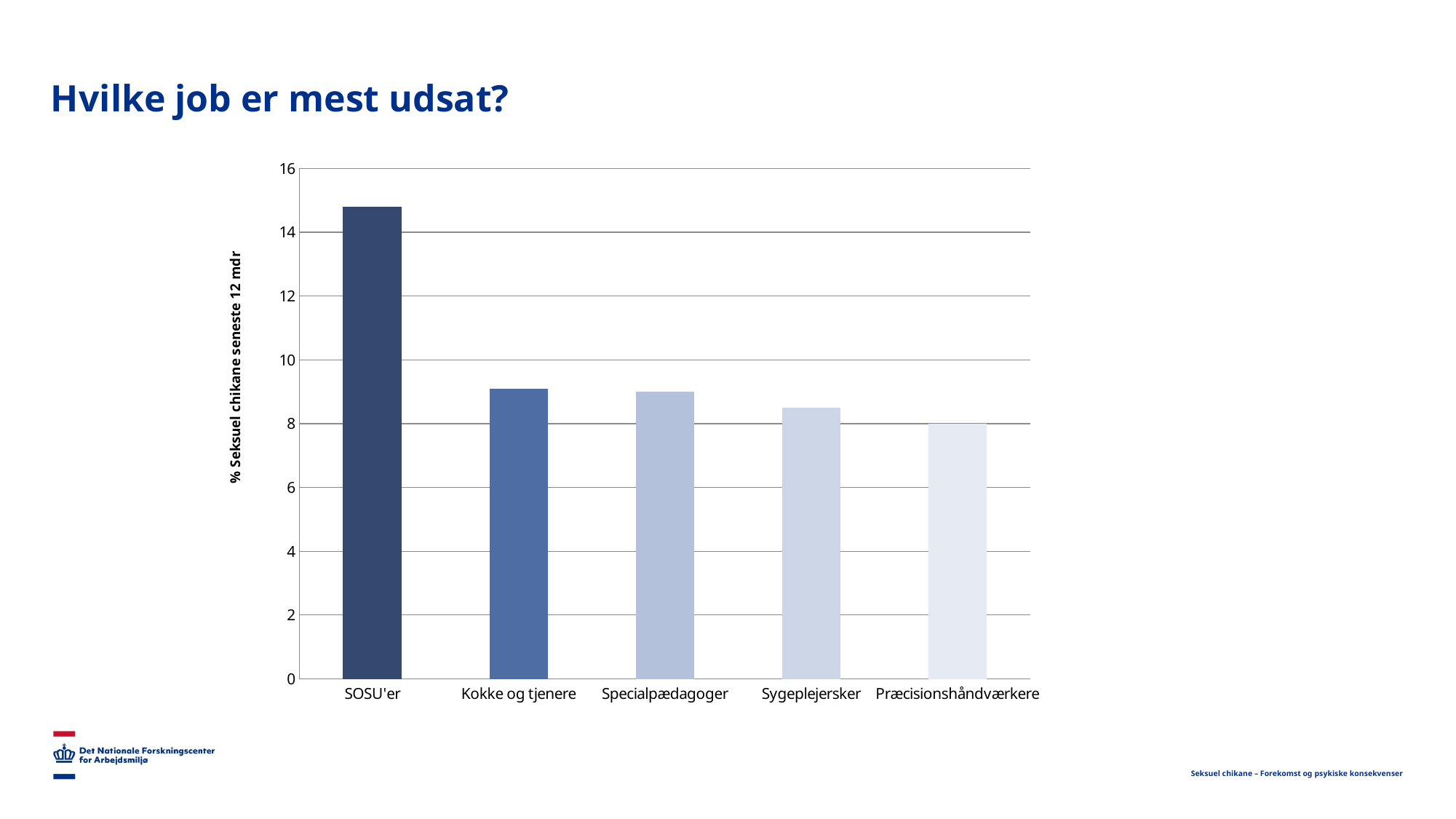
What is the label on the vertical axis of the chart? % Seksuel chikane seneste 12 mdr What kind of chart is shown on the slide? bar chart Is the value for Sygeplejersker greater or less than 8? greater Is the value for SOSU'er greater or less than 14? greater Is the value for Specialpædagoger greater or less than 8? greater Which job category has the lowest value in the chart? Præcisionshåndværkere How many job categories are shown in the chart? 5 Do the values rise or fall from left to right across the categories? fall Which job category has the highest value in the chart? SOSU'er Which is larger, the value for SOSU'er or the value for Sygeplejersker? SOSU'er What is the title of the slide? Hvilke job er mest udsat?